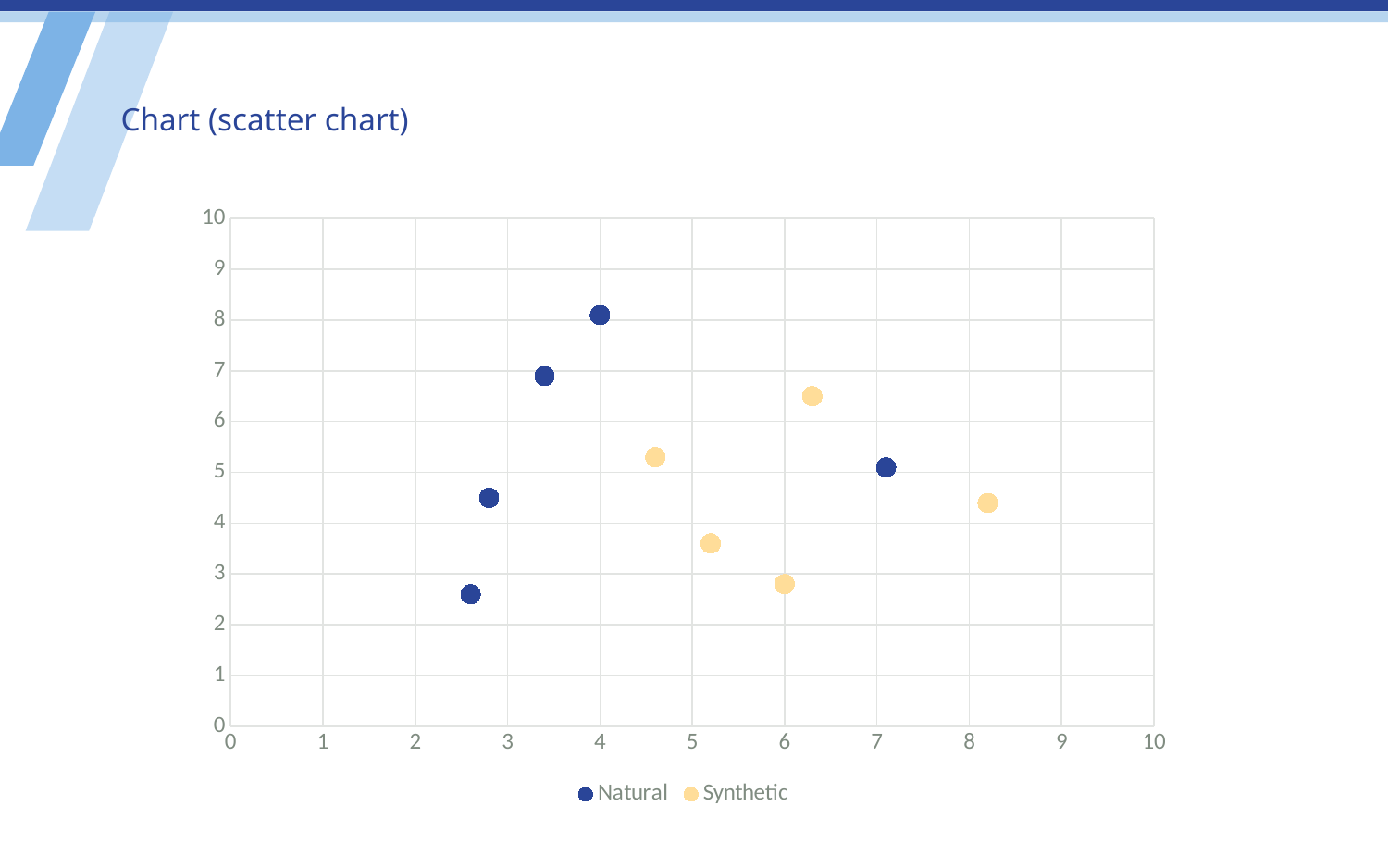
Is the y value of the rightmost Synthetic point greater or less than 5? less What kind of chart is shown on the slide? scatter chart Is the y value of the highest Synthetic point greater or less than 6? greater How many points are plotted in total on the chart? 10 How many points are plotted for the Natural series? 5 How many points are plotted for the Synthetic series? 5 What is the title of the chart? Chart (scatter chart) How many series does the legend list? 2 Is the y value of the highest Natural point greater or less than 7? greater Which series contains the point with the largest x value? Synthetic What are the two series named in the legend? Natural and Synthetic Which series contains the point with the highest y value? Natural